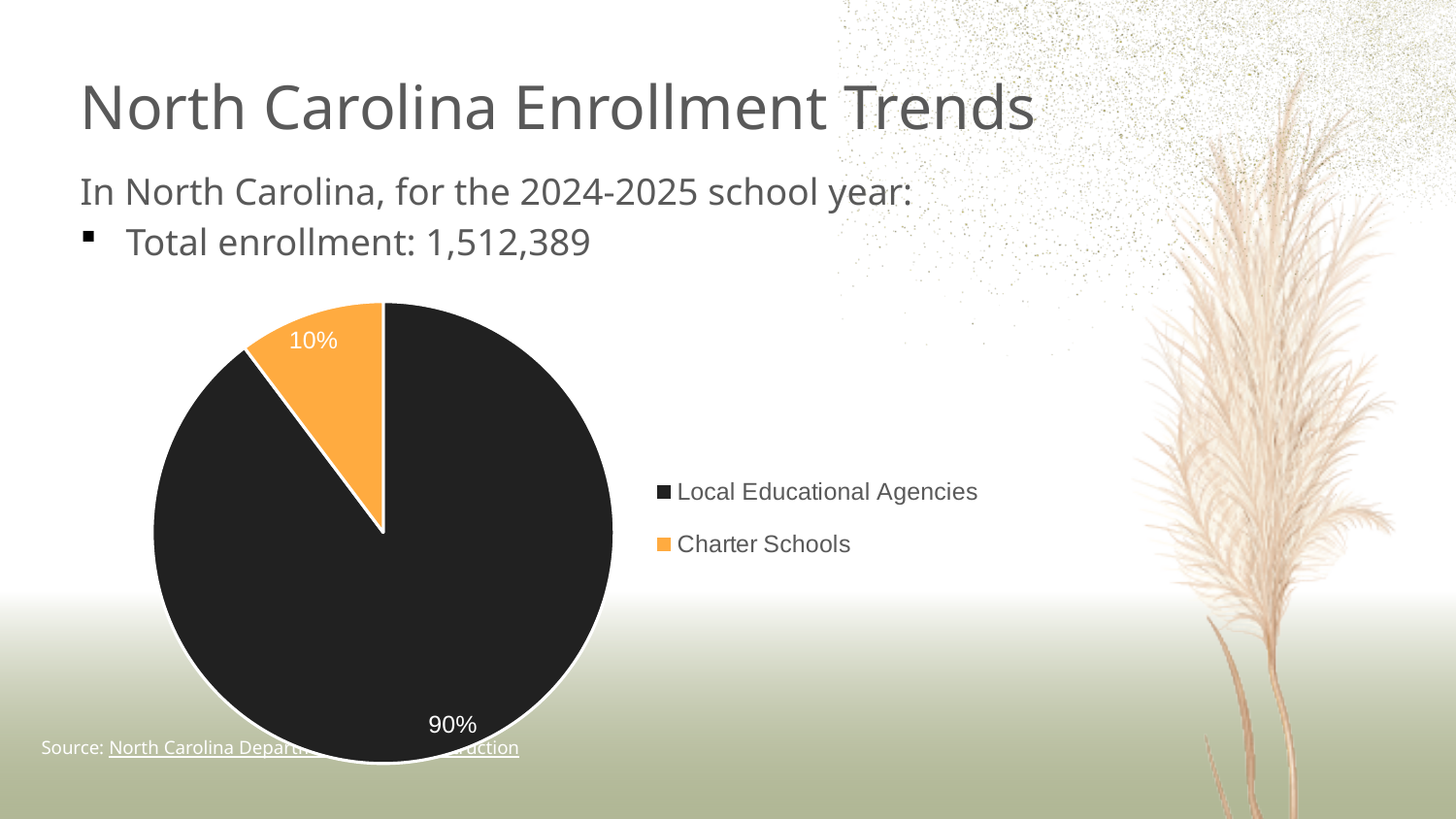
How many slices does the pie chart have? 2 Which category has the largest slice of the pie? Local Educational Agencies Which is larger, the share for Local Educational Agencies or the share for Charter Schools? Local Educational Agencies Which category has the smallest slice of the pie? Charter Schools How many entries does the legend list? 2 What kind of chart is shown on the slide? pie chart What share of the pie is Charter Schools? 10% What share of the pie is Local Educational Agencies? 90% What is the difference in percentage points between the Local Educational Agencies share and the Charter Schools share? 80 What colour is the Local Educational Agencies slice? black What colour is the Charter Schools slice? orange